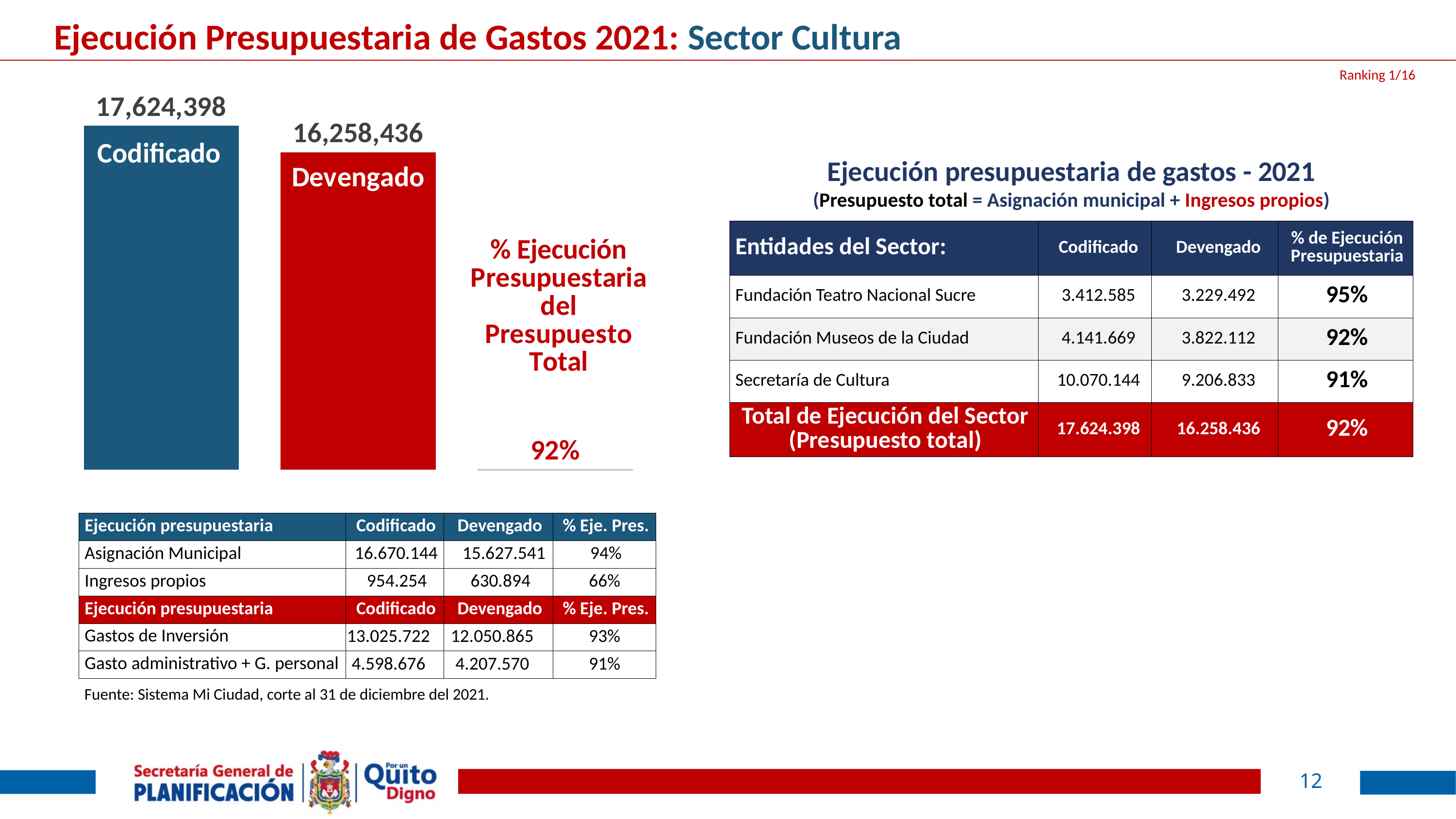
In the bar chart, what colour is the Codificado bar? blue In the bar chart, what is the difference between the Codificado and Devengado values? 1,365,962 In the bar chart, what is the value of the Codificado bar? 17,624,398 In the bar chart, what is the value of the Devengado bar? 16,258,436 What kind of chart is shown on the left of the slide? bar chart In the bar chart, which bar has the lowest value? Devengado What percentage is shown next to the bar chart as the % Ejecución Presupuestaria del Presupuesto Total? 92% In the bar chart, what colour is the Devengado bar? red In the bar chart, which bar is taller, Codificado or Devengado? Codificado How many bars are plotted in the bar chart? 2 In the bar chart, which bar has the highest value? Codificado